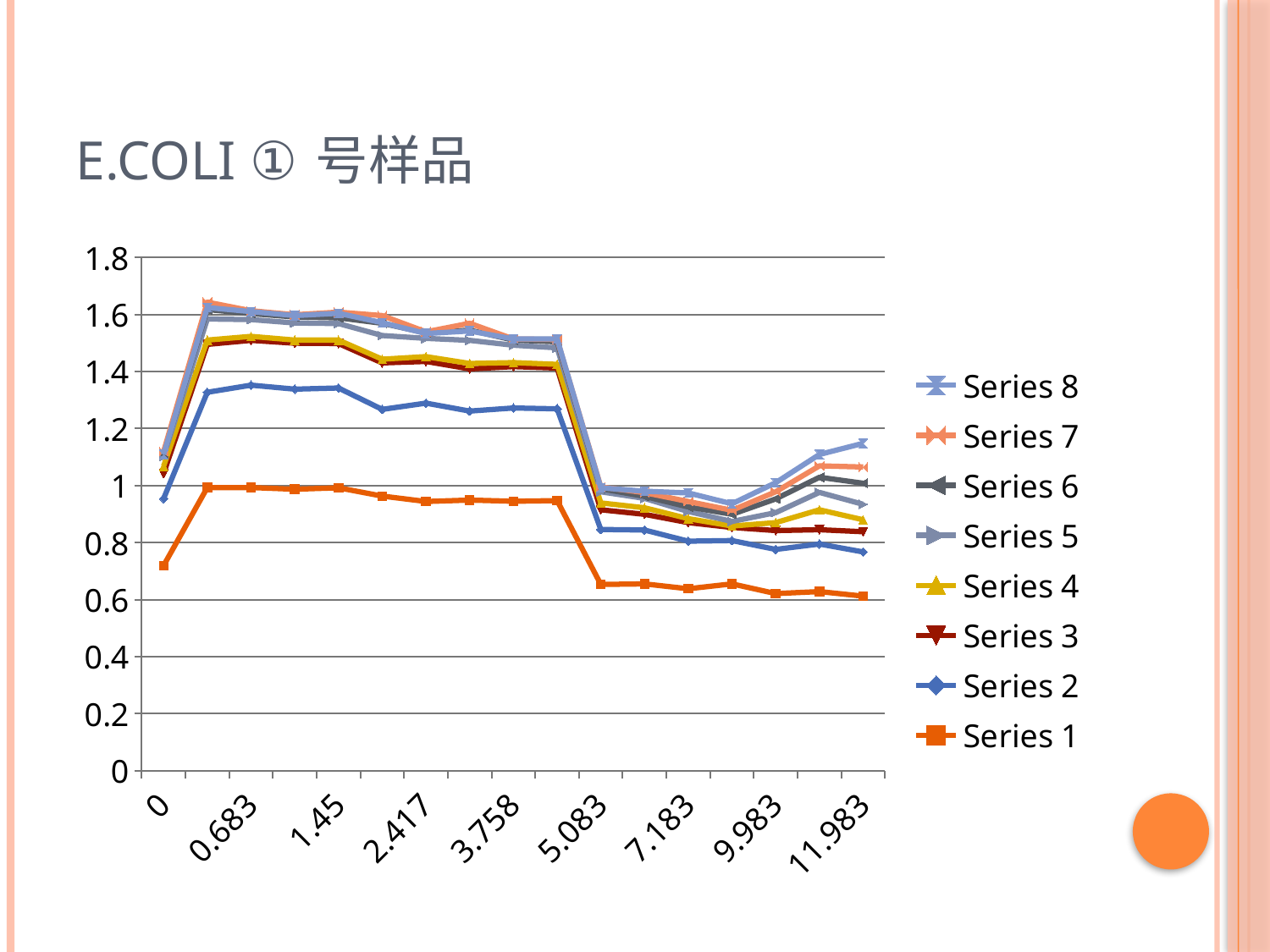
What is the maximum value shown on the vertical axis? 1.8 Which series has the highest value at x = 11.983? Series 8 Is the value of Series 8 at x = 11.983 greater or less than 1? greater Does Series 8 rise or fall between x = 0.683 and x = 11.983? fall What is the title of the slide? E.COLI ① 号样品 Which series is plotted lowest across the whole chart? Series 1 Is the value of Series 2 at x = 0.683 greater or less than 1.2? greater Is the value of Series 1 at x = 0 greater or less than 0.8? less What kind of chart is shown on the slide? line chart How many series does the legend list? 8 At x = 11.983, which is larger: Series 1 or Series 8? Series 8